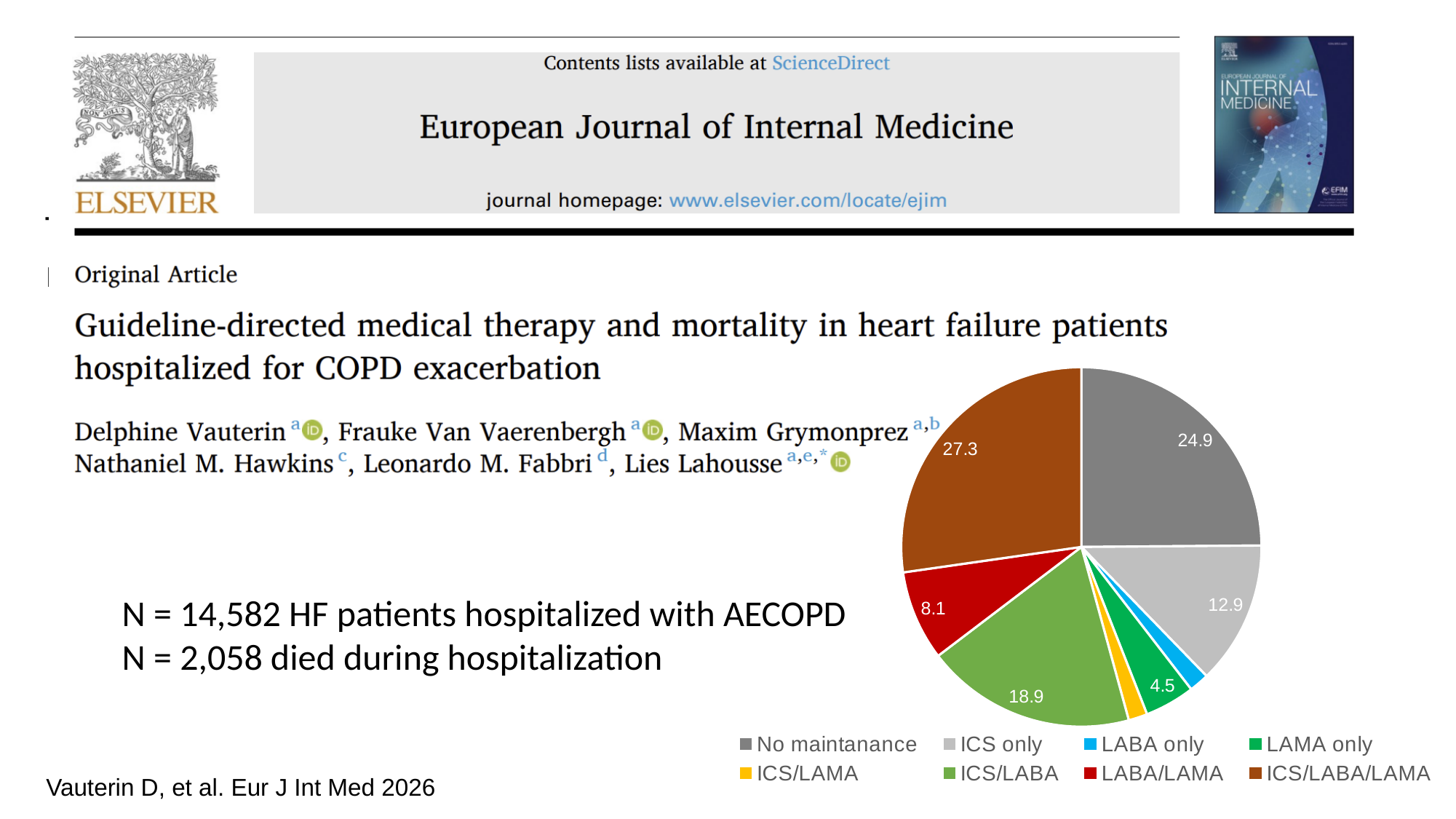
What value is shown for the LABA/LAMA slice of the pie chart? 8.1 Which slice is larger in the pie chart, LABA/LAMA or LAMA only? LABA/LAMA Which slice is larger in the pie chart, ICS/LABA or ICS only? ICS/LABA What value is shown for the LAMA only slice of the pie chart? 4.5 What type of chart is shown on the slide? Pie chart Which category has the largest slice in the pie chart? ICS/LABA/LAMA What is the difference between the ICS/LABA value and the ICS only value in the pie chart? 6.0 What is the difference between the ICS/LABA/LAMA value and the No maintanance value in the pie chart? 2.4 What value is shown for the ICS/LABA/LAMA slice of the pie chart? 27.3 What value is shown for the ICS only slice of the pie chart? 12.9 What value is shown for the No maintanance slice of the pie chart? 24.9 How many categories does the legend of the pie chart list? 8